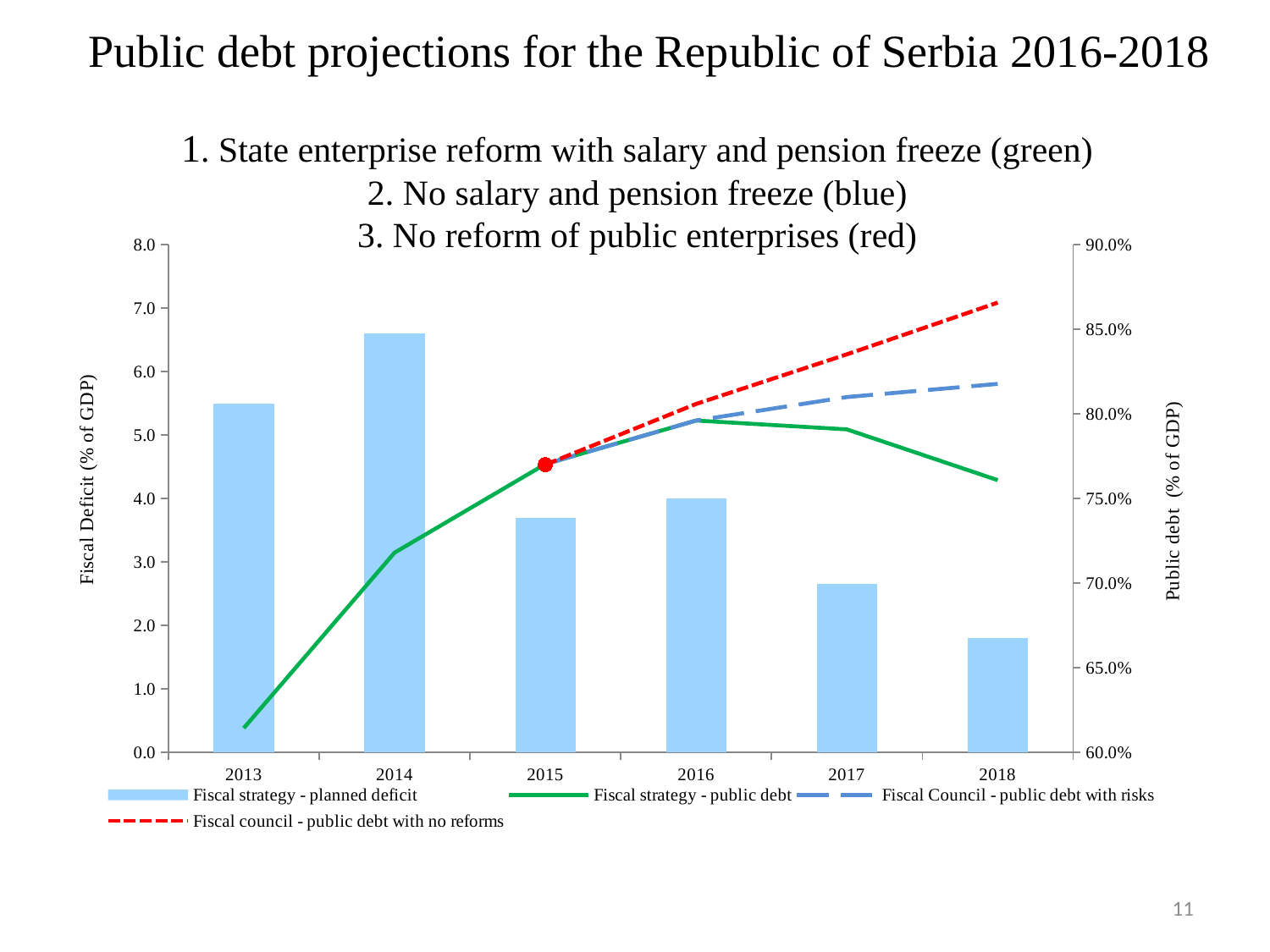
Which year has the larger Fiscal strategy - planned deficit bar, 2013 or 2015? 2013 Is the Fiscal strategy - planned deficit for 2015 greater or less than 4.0? less Does the Fiscal strategy - public debt line rise or fall from 2013 to 2016? rise Which series is drawn as a red dashed line? Fiscal council - public debt with no reforms In which year is the Fiscal strategy - planned deficit bar the lowest? 2018 How many years are shown on the x axis of the chart? 6 What kind of chart is shown on the slide? A combined bar and line chart Is the Fiscal council - public debt with no reforms value for 2018 greater or less than 85.0%? greater How many series does the chart's legend list? 4 Is the Fiscal strategy - planned deficit for 2013 greater or less than 5.0? greater In which year is the Fiscal strategy - planned deficit bar the highest? 2014